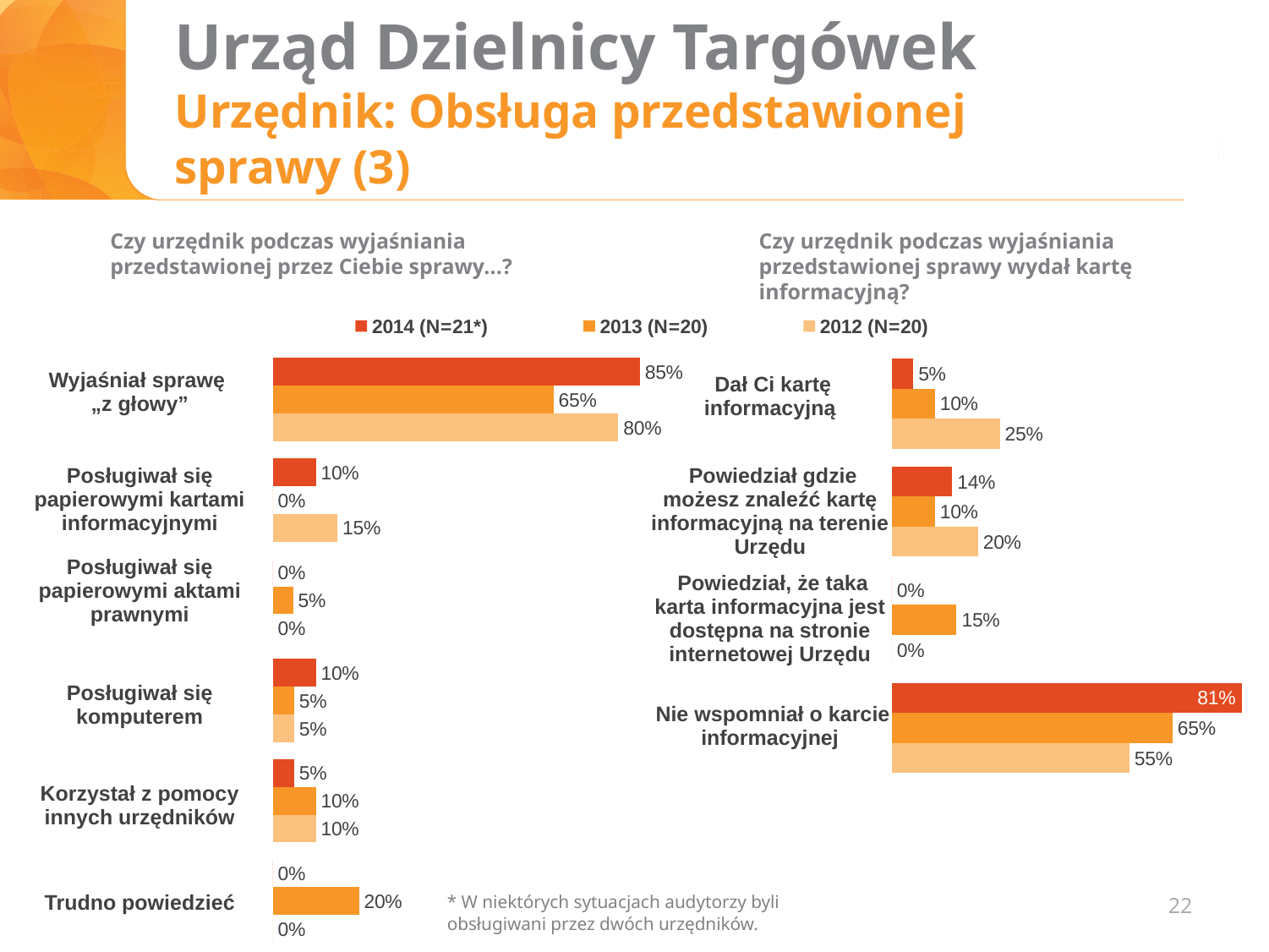
In the right chart ("Czy urzędnik podczas wyjaśniania przedstawionej sprawy wydał kartę informacyjną?"), what is the 2014 value for "Nie wspomniał o karcie informacyjnej"? 81% In the right chart, what is the 2012 value for "Dał Ci kartę informacyjną"? 25% In the left chart, what is the 2012 value for "Posługiwał się papierowymi kartami informacyjnymi"? 15% In the left chart, what is the 2013 value for "Trudno powiedzieć"? 20% In the left chart, how many categories are shown? 6 How many series does the legend list? 3 In the left chart, what is the difference between the 2014 and 2013 values for "Wyjaśniał sprawę „z głowy”"? 20% In the left chart ("Czy urzędnik podczas wyjaśniania przedstawionej przez Ciebie sprawy...?"), what is the 2014 value for "Wyjaśniał sprawę „z głowy”"? 85% In the right chart, which is larger for "Powiedział gdzie możesz znaleźć kartę informacyjną na terenie Urzędu": the 2014 value or the 2012 value? 2012 What kind of chart is the right chart? Bar chart In the left chart, which category has the highest 2014 value? Wyjaśniał sprawę „z głowy” In the right chart, what is the difference between the 2014 and 2012 values for "Nie wspomniał o karcie informacyjnej"? 26%